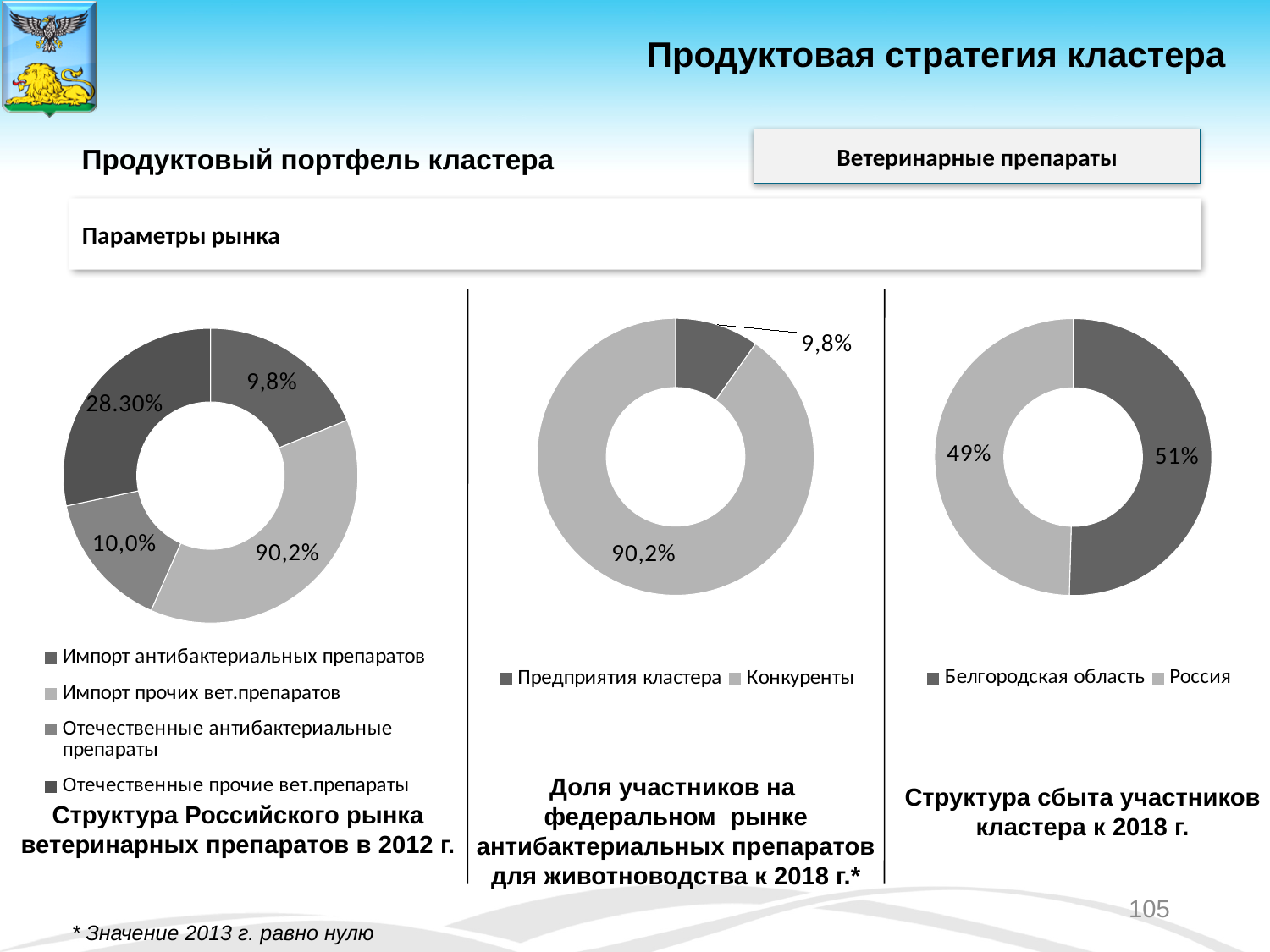
In the chart 'Структура сбыта участников кластера к 2018 г.', which category has the larger share? Белгородская область In the chart 'Структура сбыта участников кластера к 2018 г.', what share is shown for Россия? 49% In the middle chart, which is larger: the share of Предприятия кластера or the share of Конкуренты? Конкуренты In the middle chart, what is the difference between the shares of Конкуренты and Предприятия кластера? 80,4% How many entries does the legend of the chart 'Структура сбыта участников кластера к 2018 г.' list? 2 How many categories does the legend of the chart 'Структура Российского рынка ветеринарных препаратов в 2012 г.' list? 4 What type of chart is used for 'Структура сбыта участников кластера к 2018 г.'? Doughnut (pie) chart In the chart 'Структура Российского рынка ветеринарных препаратов в 2012 г.', what value is labelled on the slice for Импорт антибактериальных препаратов? 9,8% In the chart 'Структура сбыта участников кластера к 2018 г.', what is the difference between the shares of Белгородская область and Россия? 2% In the chart 'Доля участников на федеральном рынке антибактериальных препаратов для животноводства к 2018 г.', what share is shown for Конкуренты? 90,2% In the chart 'Доля участников на федеральном рынке антибактериальных препаратов для животноводства к 2018 г.', what share is shown for Предприятия кластера? 9,8% In the chart 'Структура сбыта участников кластера к 2018 г.', what share is shown for Белгородская область? 51%